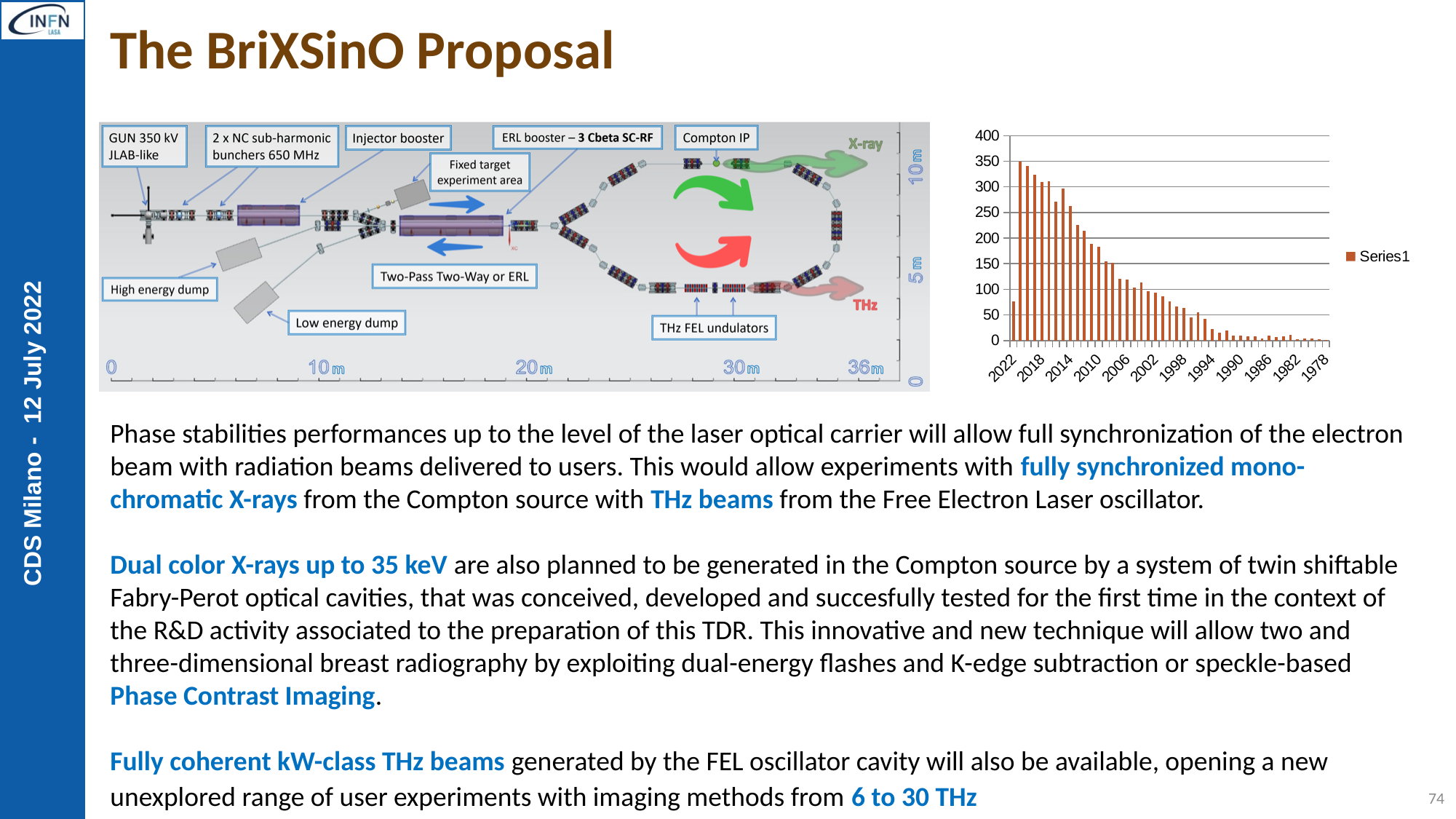
In the bar chart, which has the larger value, 2022 or 2018? 2018 In the bar chart, is the value for 2014 greater or less than 150? greater In the bar chart, is the value for 1978 greater or less than 50? less In the bar chart, is the value for 2018 greater or less than 200? greater What is the highest value shown on the vertical axis of the bar chart? 400 How many series does the legend of the bar chart list? 1 In the bar chart, do the values generally rise or fall when moving from 2018 toward 1978 along the x axis? fall What kind of chart is shown on the right of the slide? bar chart In the bar chart, which has the larger value, 2018 or 1998? 2018 What is the name of the series shown in the bar chart's legend? Series1